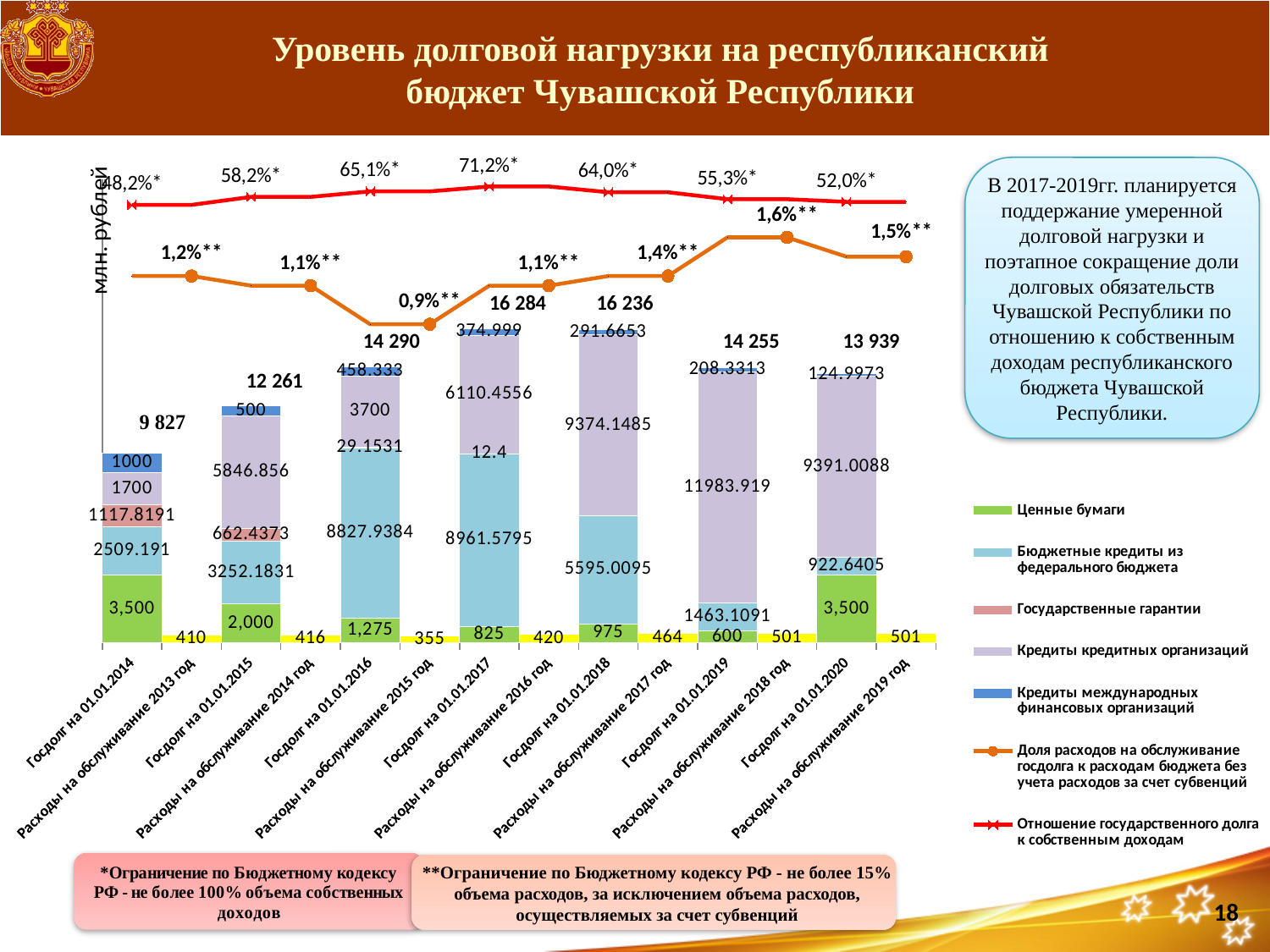
How many series does the legend list? 7 What is the value shown for Расходы на обслуживание 2015 год? 355 Which date has the lowest total state debt (Госдолг) bar? Госдолг на 01.01.2014 What is the value of the orange line (Доля расходов на обслуживание госдолга) at its lowest point? 0,9% What is the value of the red line (Отношение государственного долга к собственным доходам) at its highest point? 71,2% What is the value of Ценные бумаги (green segment) in the bar for Госдолг на 01.01.2016? 1,275 What is the total state debt (Госдолг) shown above the bar for 01.01.2017? 16 284 What kind of chart is shown on the slide? Stacked bar chart with line series How does the red line (Отношение государственного долга к собственным доходам) change from 01.01.2017 to 01.01.2020? It falls Which date has the highest total state debt (Госдолг) bar? Госдолг на 01.01.2017 Which is larger: the total state debt on 01.01.2018 or on 01.01.2020? 01.01.2018 What is the difference between the total state debt on 01.01.2017 (16 284) and on 01.01.2014 (9 827)? 6 457